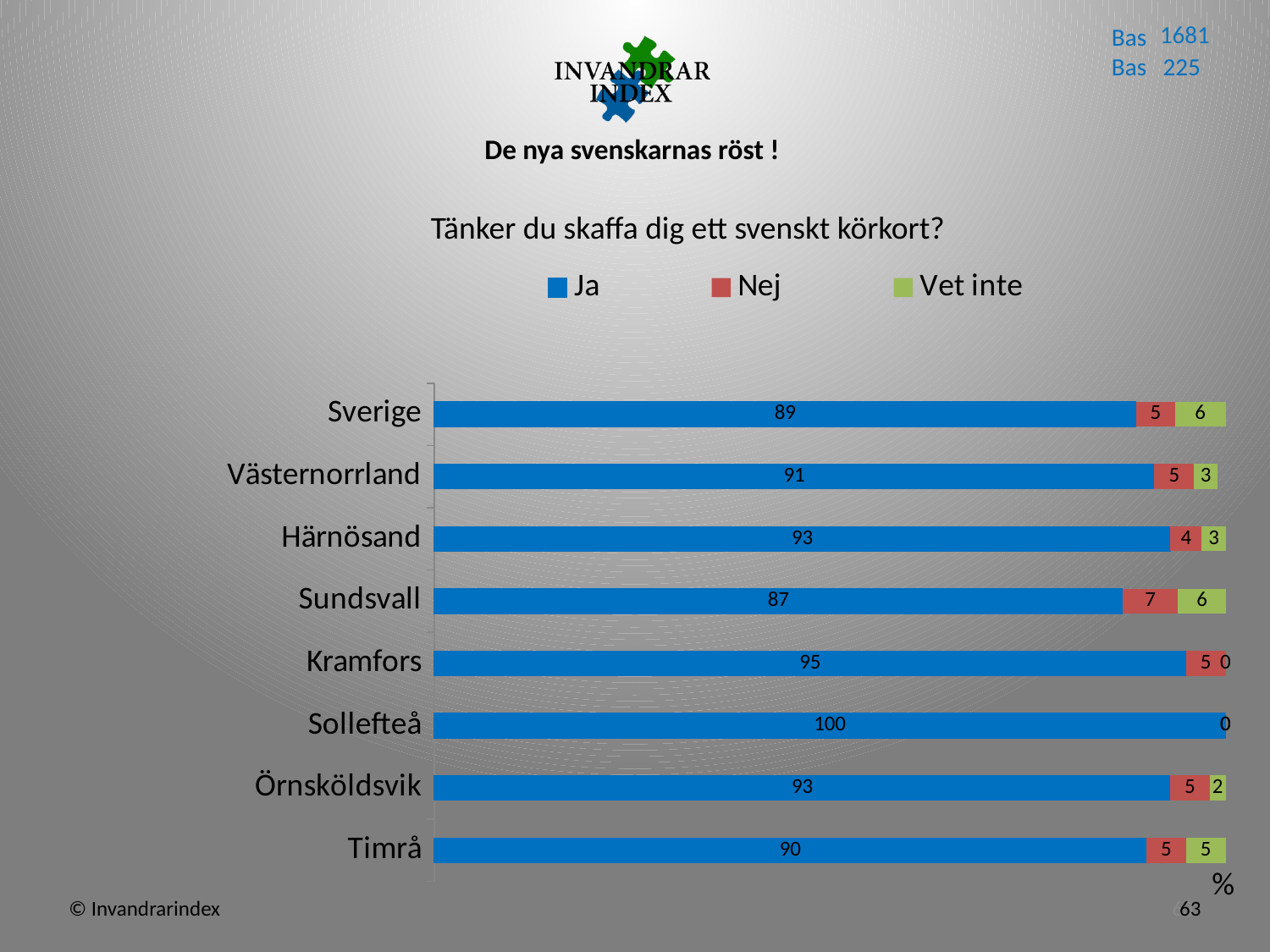
What is the total of the stacked bar for Sverige? 100 How many categories are shown on the chart? 8 Which has a larger Ja value, Kramfors or Timrå? Kramfors Which category has the lowest value for Ja? Sundsvall What kind of chart is shown on the slide? Stacked bar chart What is the difference between the Ja values for Härnösand and Sundsvall? 6 What is the title of the chart? Tänker du skaffa dig ett svenskt körkort? Which category has the highest value for Ja? Sollefteå What is the value for Vet inte for Västernorrland? 3 What is the value for Ja for Sverige? 89 What is the value for Nej for Sundsvall? 7 How many series does the legend list? 3